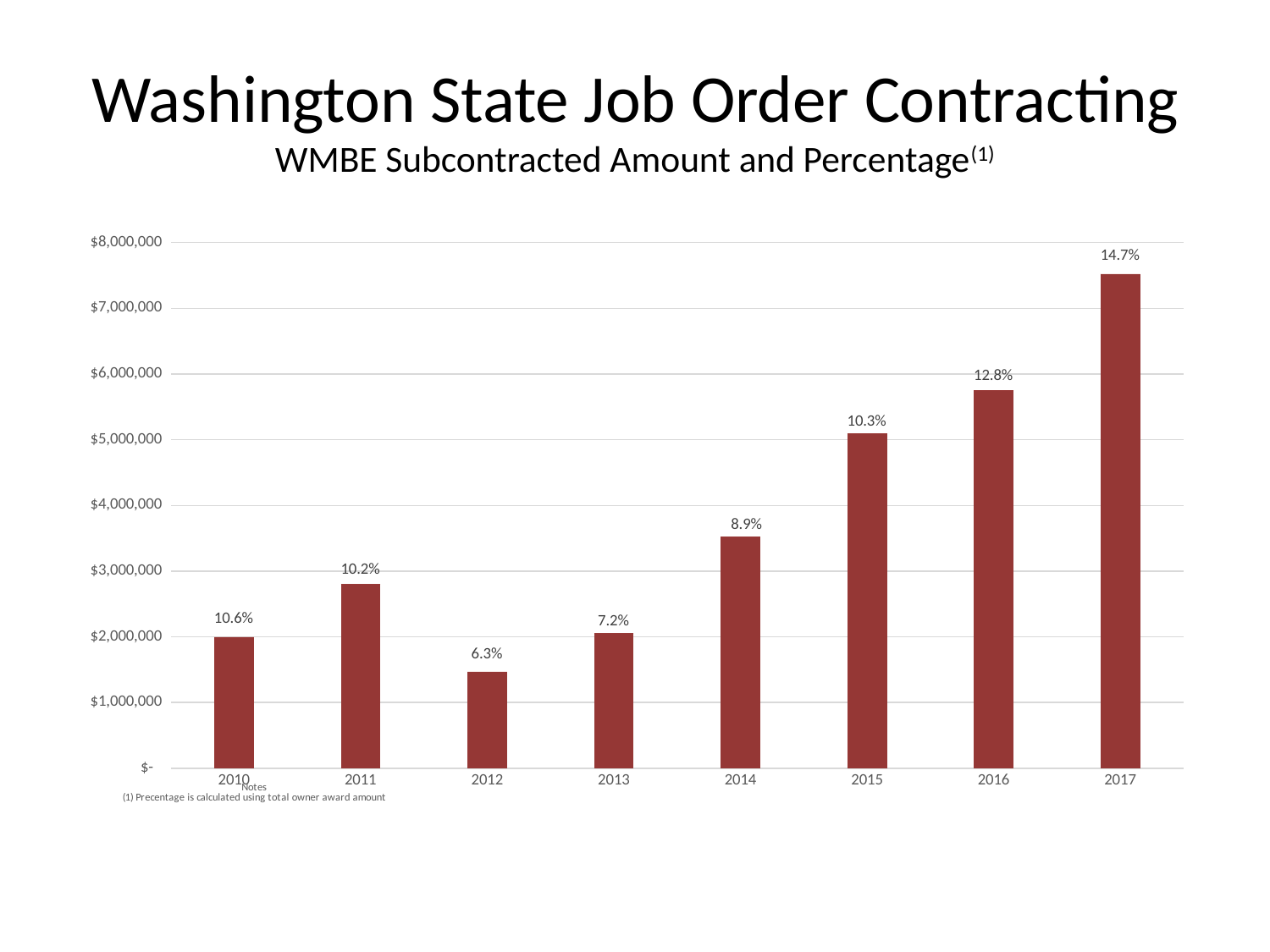
What percentage label is shown on the bar for 2017? 14.7% Which bar is taller, 2011 or 2013? 2011 Is the value for 2014 greater or less than $3,000,000? greater What kind of chart is shown on the slide? Bar chart What percentage label is shown on the bar for 2012? 6.3% How many years are shown on the x axis? 8 What percentage label is shown on the bar for 2015? 10.3% Which year has the lowest percentage label? 2012 Is the value for 2016 greater or less than $6,000,000? less Which year has the shortest bar? 2012 Which year has the tallest bar? 2017 Do the bar values rise or fall from 2013 to 2017? Rise